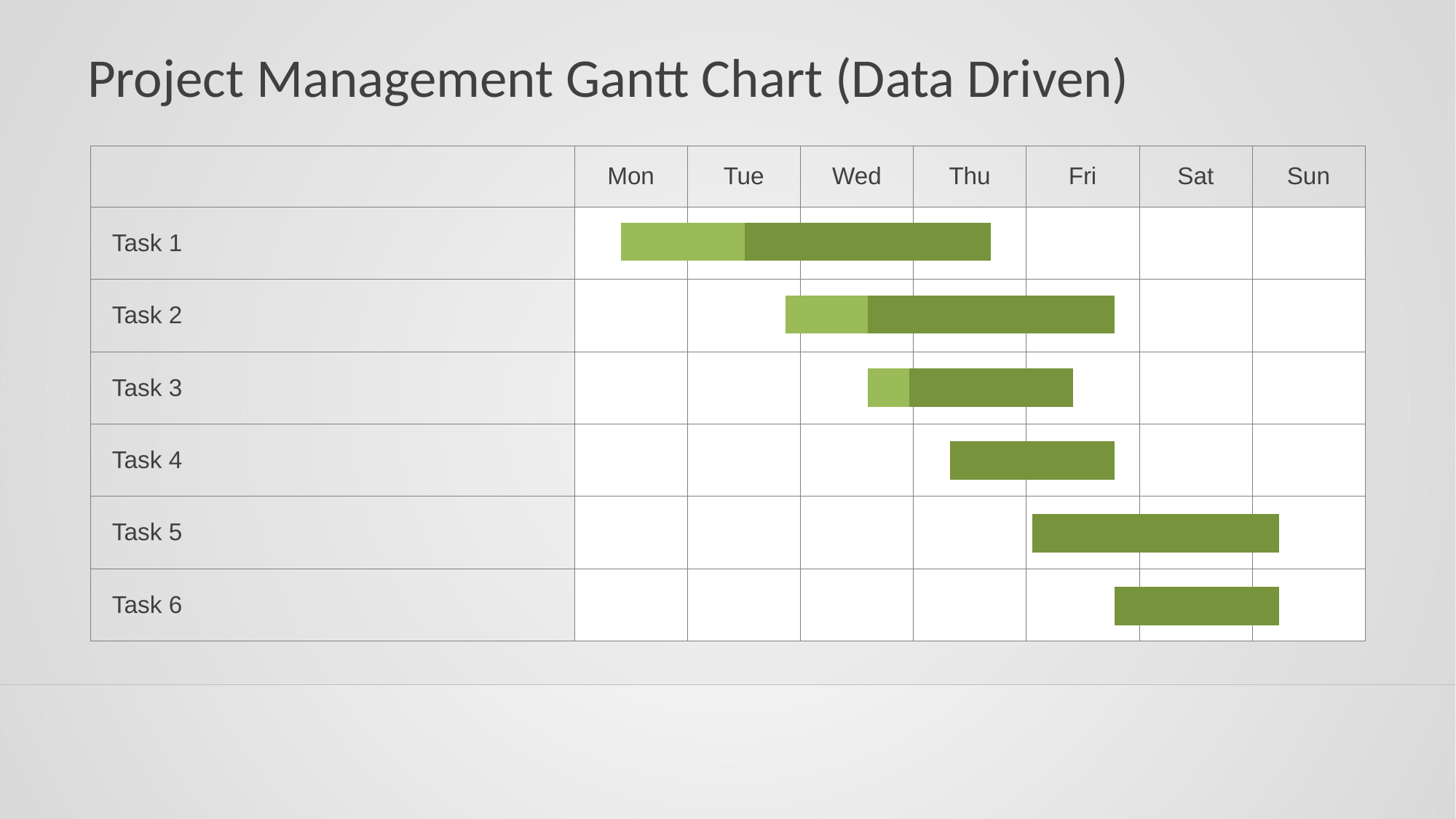
What is the title of the slide? Project Management Gantt Chart (Data Driven) Which task has the longest bar? Task 1 How many day columns does the Gantt chart have? 7 Which task starts latest in the week? Task 6 How many tasks have a light green segment at the start of their bar? 3 On which day does Task 5 end? Sun On which day does Task 1 begin? Mon How many tasks are listed in the Gantt chart? 6 Which bar is longer, Task 2 or Task 4? Task 2 What kind of chart is shown on the slide? Gantt chart Which bar is longer, Task 1 or Task 3? Task 1 Which task starts earliest in the week? Task 1